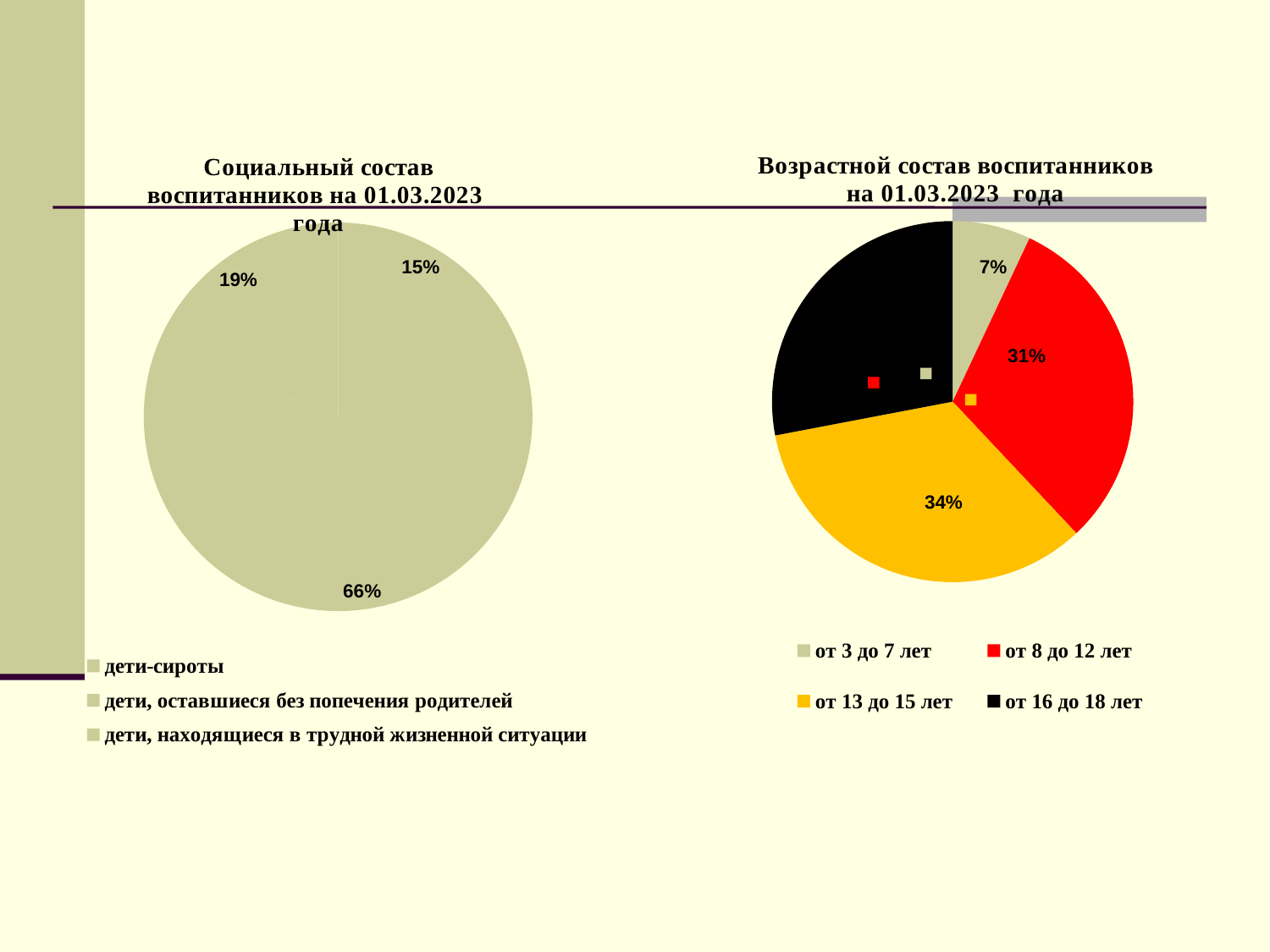
In the 'Возрастной состав воспитанников' chart on the right, which age group has the largest share? от 13 до 15 лет How many categories does the legend of the 'Социальный состав воспитанников' chart on the left list? 3 In the 'Социальный состав воспитанников на 01.03.2023 года' chart on the left, what is the value of the largest slice? 66% In the 'Возрастной состав воспитанников' chart on the right, which slice is larger: 'от 16 до 18 лет' or 'от 3 до 7 лет'? от 16 до 18 лет How many categories does the legend of the 'Возрастной состав воспитанников' chart on the right list? 4 In the 'Возрастной состав воспитанников' chart on the right, which age group has the smallest share? от 3 до 7 лет In the 'Возрастной состав воспитанников' chart on the right, how many percentage points larger is the 'от 13 до 15 лет' share than the 'от 8 до 12 лет' share? 3 percentage points In the 'Возрастной состав воспитанников' chart on the right, what share is shown for 'от 13 до 15 лет'? 34% What kind of chart is the 'Возрастной состав воспитанников на 01.03.2023 года' chart on the right? pie chart In the 'Возрастной состав воспитанников' chart on the right, what share is shown for 'от 3 до 7 лет'? 7% In the 'Возрастной состав воспитанников' chart on the right, what share is shown for 'от 8 до 12 лет'? 31% In the 'Социальный состав воспитанников на 01.03.2023 года' chart on the left, what is the value of the smallest slice? 15%